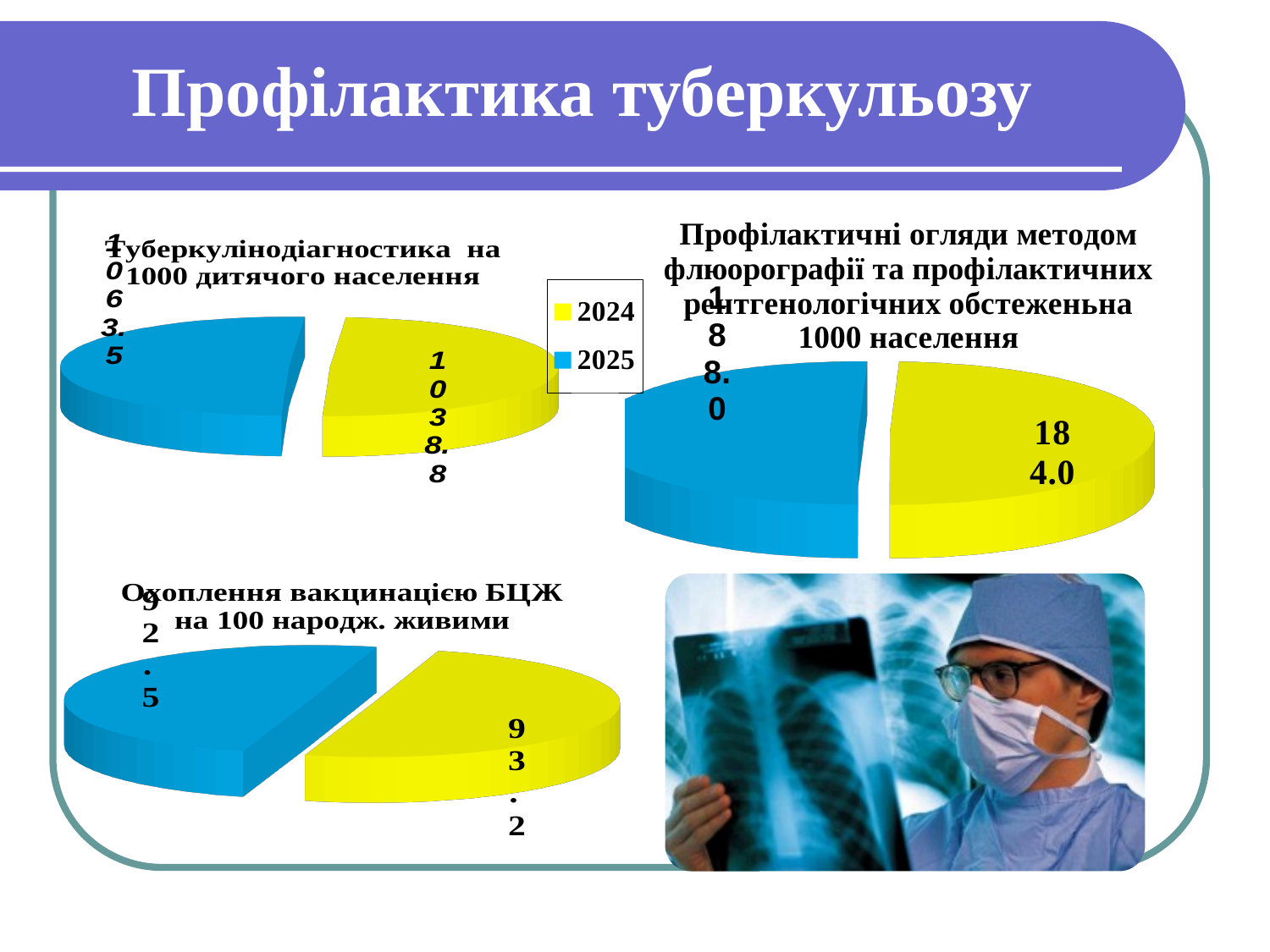
What kind of chart is the one titled 'Туберкулінодіагностика на 1000 дитячого населення'? pie chart On the chart about профілактичні огляди методом флюорографії (top right), what is the value of the yellow slice? 184.0 On the chart about профілактичні огляди методом флюорографії (top right), what is the value of the blue slice? 188.0 On the chart titled 'Охоплення вакцинацією БЦЖ на 100 народж. живими', what is the difference between the yellow and blue values? 0.7 On the chart titled 'Охоплення вакцинацією БЦЖ на 100 народж. живими', what is the value of the yellow slice? 93.2 On the chart titled 'Охоплення вакцинацією БЦЖ на 100 народж. живими', what is the value of the blue slice? 92.5 On the chart titled 'Туберкулінодіагностика на 1000 дитячого населення', what is the difference between the 2025 and 2024 values? 24.7 On the chart about профілактичні огляди методом флюорографії (top right), which slice has the larger value, blue or yellow? blue On the chart about профілактичні огляди методом флюорографії (top right), what is the difference between the blue and yellow values? 4.0 On the chart titled 'Туберкулінодіагностика на 1000 дитячого населення', what is the value of the blue (2025) slice? 1063.5 How many entries does the legend next to the 'Туберкулінодіагностика' chart list? 2 On the chart titled 'Туберкулінодіагностика на 1000 дитячого населення', what is the value of the yellow (2024) slice? 1038.8